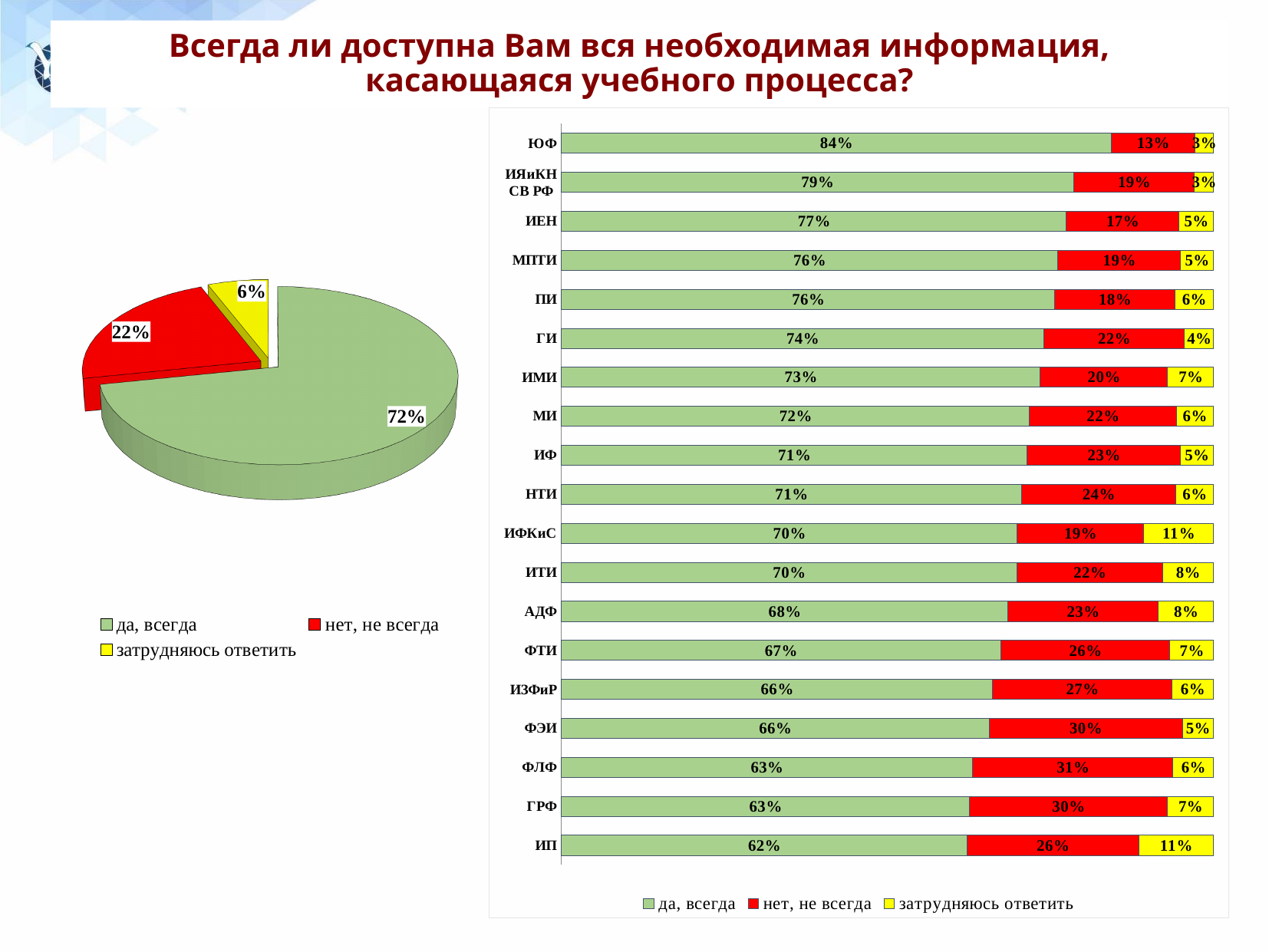
How many series does the legend of the bar chart on the right list? 3 In the pie chart on the left, what share of respondents answered "затрудняюсь ответить"? 6% In the pie chart on the left, what share of respondents answered "да, всегда"? 72% In the bar chart on the right, what is the difference between the "да, всегда" values for ЮФ and ИП? 22% In the bar chart on the right, what is the value of "нет, не всегда" for ФЛФ? 31% How many categories are shown in the bar chart on the right? 19 In the bar chart on the right, what is the value of "затрудняюсь ответить" for ИФКиС? 11% In the bar chart on the right, which is larger: the "нет, не всегда" value for ФЭИ or for ИЕН? ФЭИ In the bar chart on the right, which category has the highest value for "да, всегда"? ЮФ What kind of chart is shown on the right side of the slide? Stacked bar chart In the bar chart on the right, what is the value of "да, всегда" for ЮФ? 84% In the bar chart on the right, which category has the lowest value for "да, всегда"? ИП